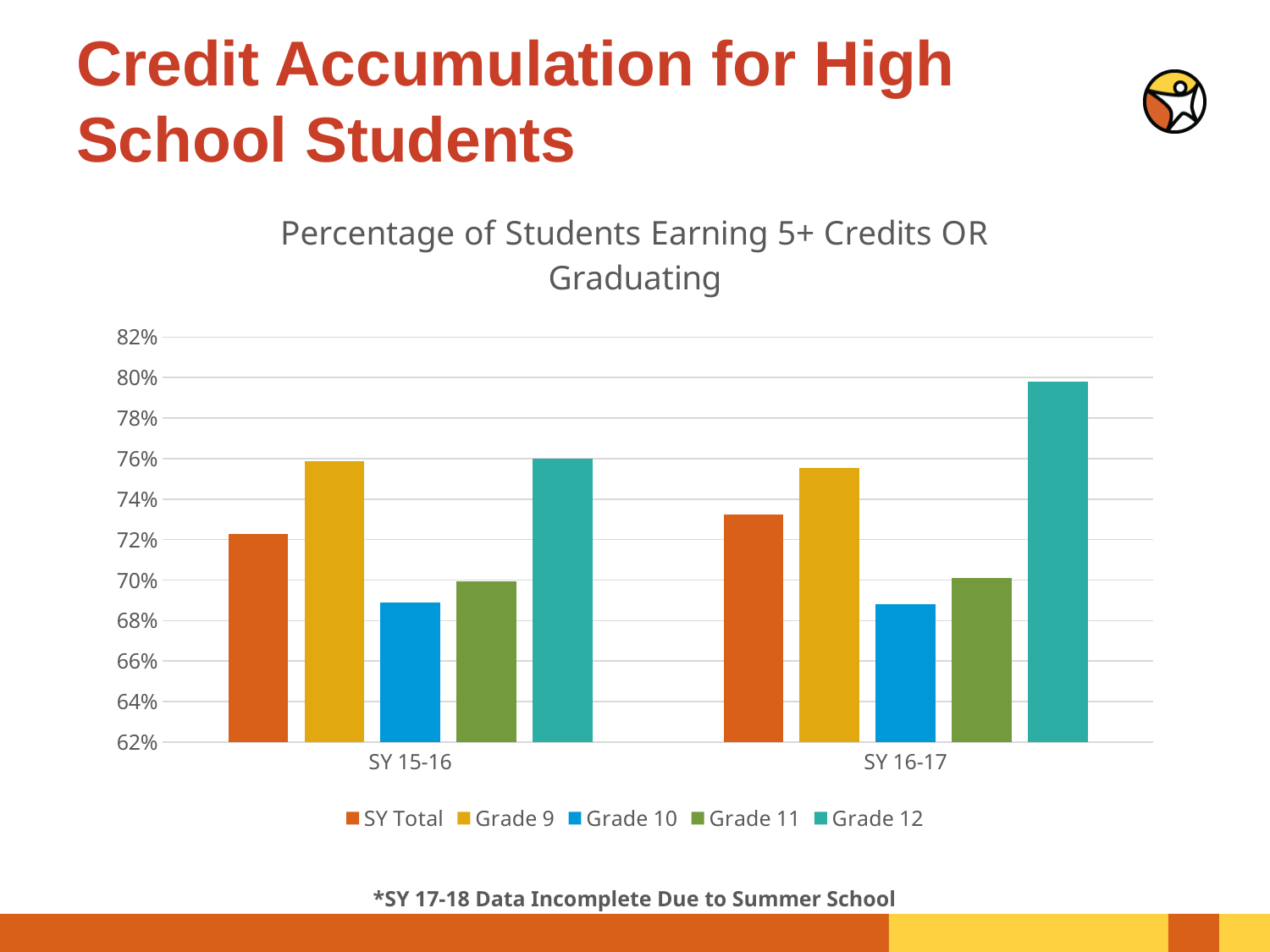
What is the title of the chart? Percentage of Students Earning 5+ Credits OR Graduating Is the value for Grade 12 in SY 16-17 greater or less than 78%? greater Is the value for Grade 9 in SY 16-17 greater or less than 74%? greater How many series does the legend list? 5 In SY 16-17, which is larger, Grade 12 or Grade 9? Grade 12 Does the Grade 12 value rise or fall from SY 15-16 to SY 16-17? rise Which series has the lowest value in SY 16-17? Grade 10 Which series has the lowest value in SY 15-16? Grade 10 Which grade has the highest value in SY 16-17? Grade 12 How many school-year categories are shown on the x axis? 2 What kind of chart is shown on the slide? bar chart Is the value for Grade 10 in SY 15-16 greater or less than 70%? less